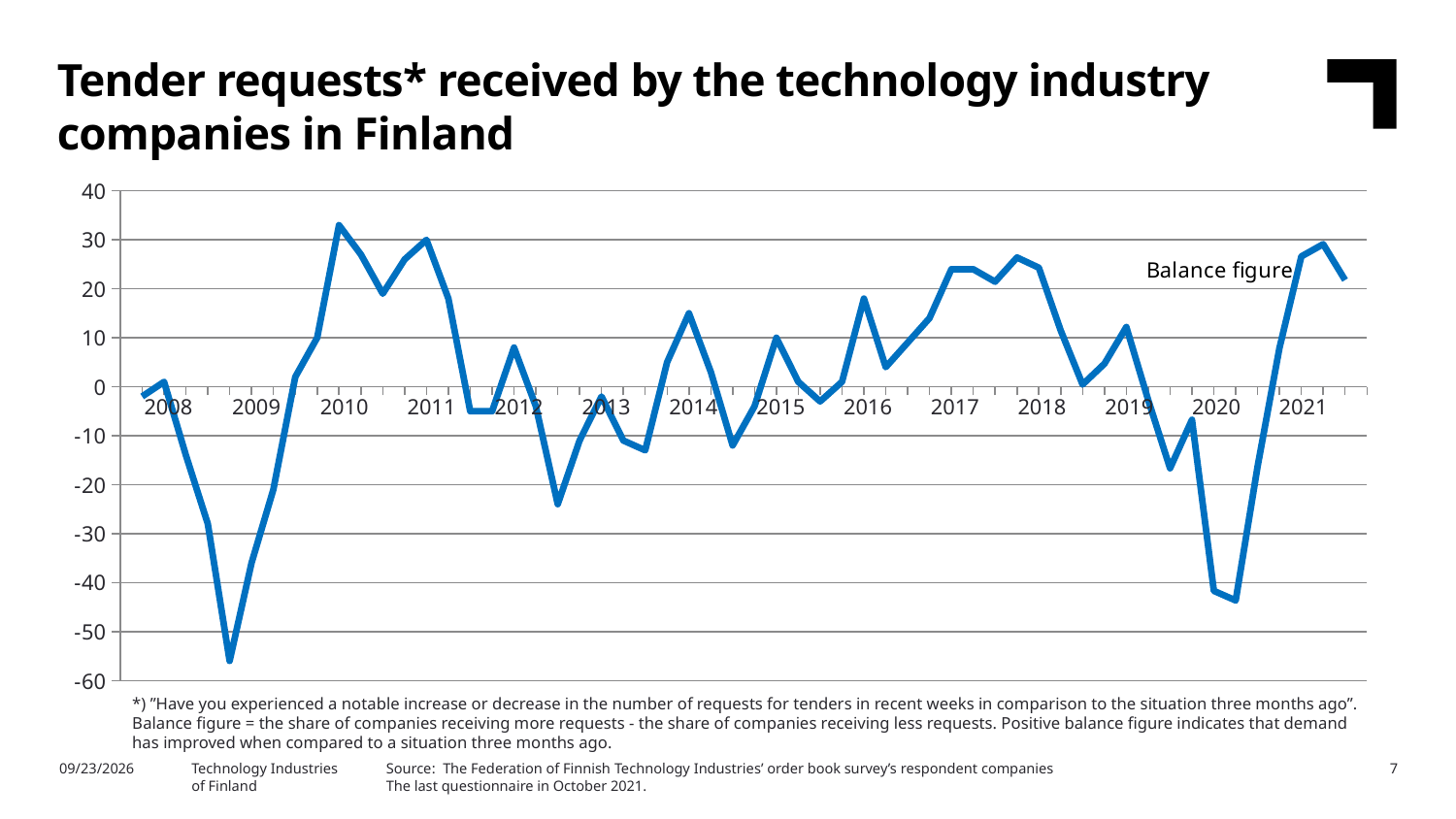
Which is higher: the peak of the balance figure in 2010 or the peak in 2017? 2010 Is the lowest point of the balance figure in 2020 greater or less than -30? less How many years are labelled on the horizontal axis? 14 Is the peak of the balance figure in 2021 greater or less than 20? greater What is the lowest value shown on the vertical axis? -60 What kind of chart is shown on the slide? line chart Is the lowest point of the balance figure on the chart greater or less than -50? less How many data series does the chart show? 1 What is the label of the series plotted on the chart? Balance figure Does the balance figure rise or fall from its low point in 2020 to its peak in 2021? rise